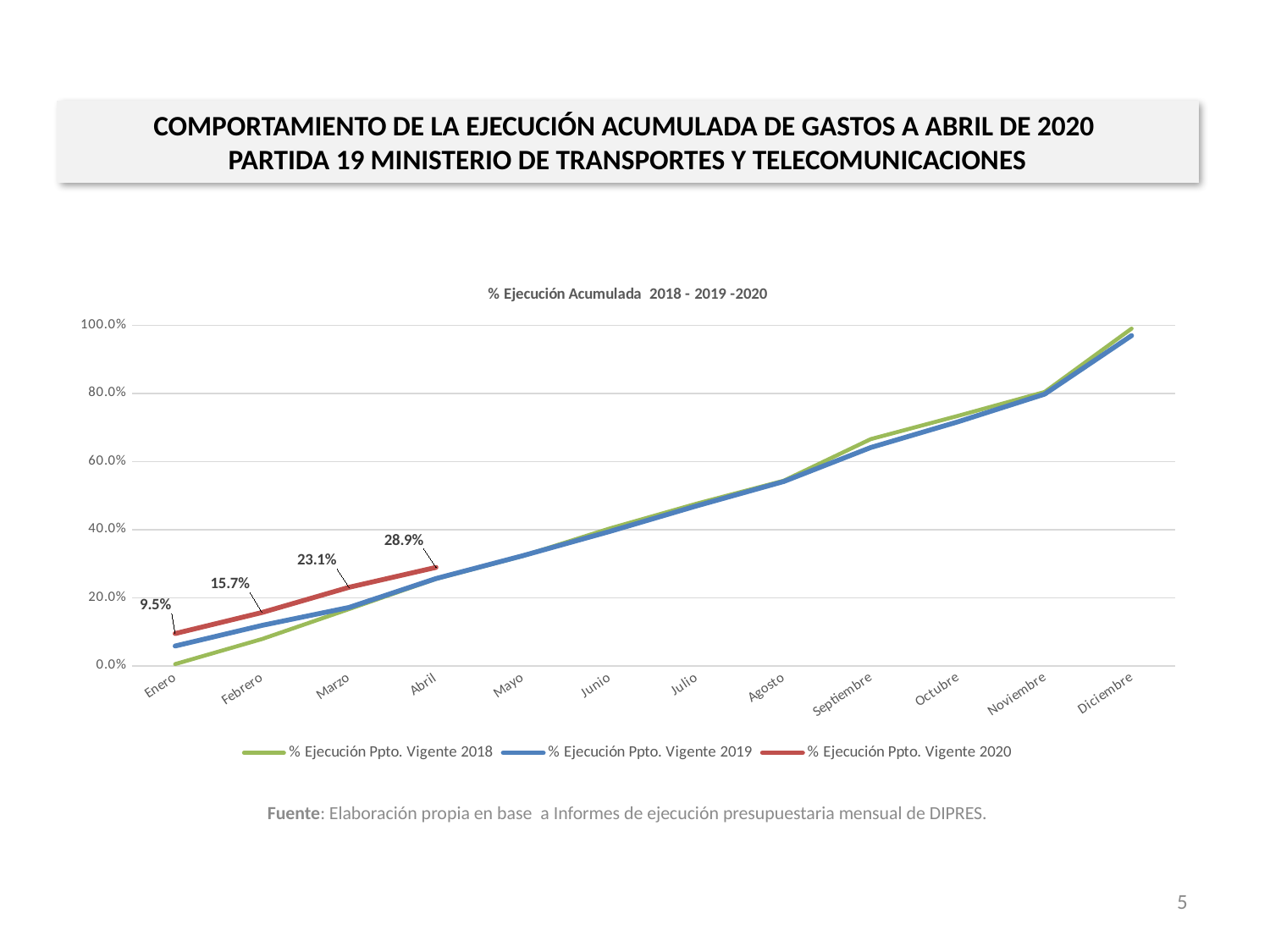
What kind of chart is shown on the slide? line chart What is the value of % Ejecución Ppto. Vigente 2020 for Abril? 28.9% Is the value of % Ejecución Ppto. Vigente 2019 for Diciembre greater or less than 80%? greater How many series does the legend list? 3 How many months are shown on the x axis? 12 What is the value of % Ejecución Ppto. Vigente 2020 for Marzo? 23.1% What is the value of % Ejecución Ppto. Vigente 2020 for Enero? 9.5% What is the difference between the Abril and Enero values of % Ejecución Ppto. Vigente 2020? 19.4% Which is larger for Enero: % Ejecución Ppto. Vigente 2020 or % Ejecución Ppto. Vigente 2018? % Ejecución Ppto. Vigente 2020 Is the value of % Ejecución Ppto. Vigente 2018 for Enero greater or less than 20%? less What is the value of % Ejecución Ppto. Vigente 2020 for Febrero? 15.7% Does the % Ejecución Ppto. Vigente 2020 series rise or fall from Enero to Abril? rise